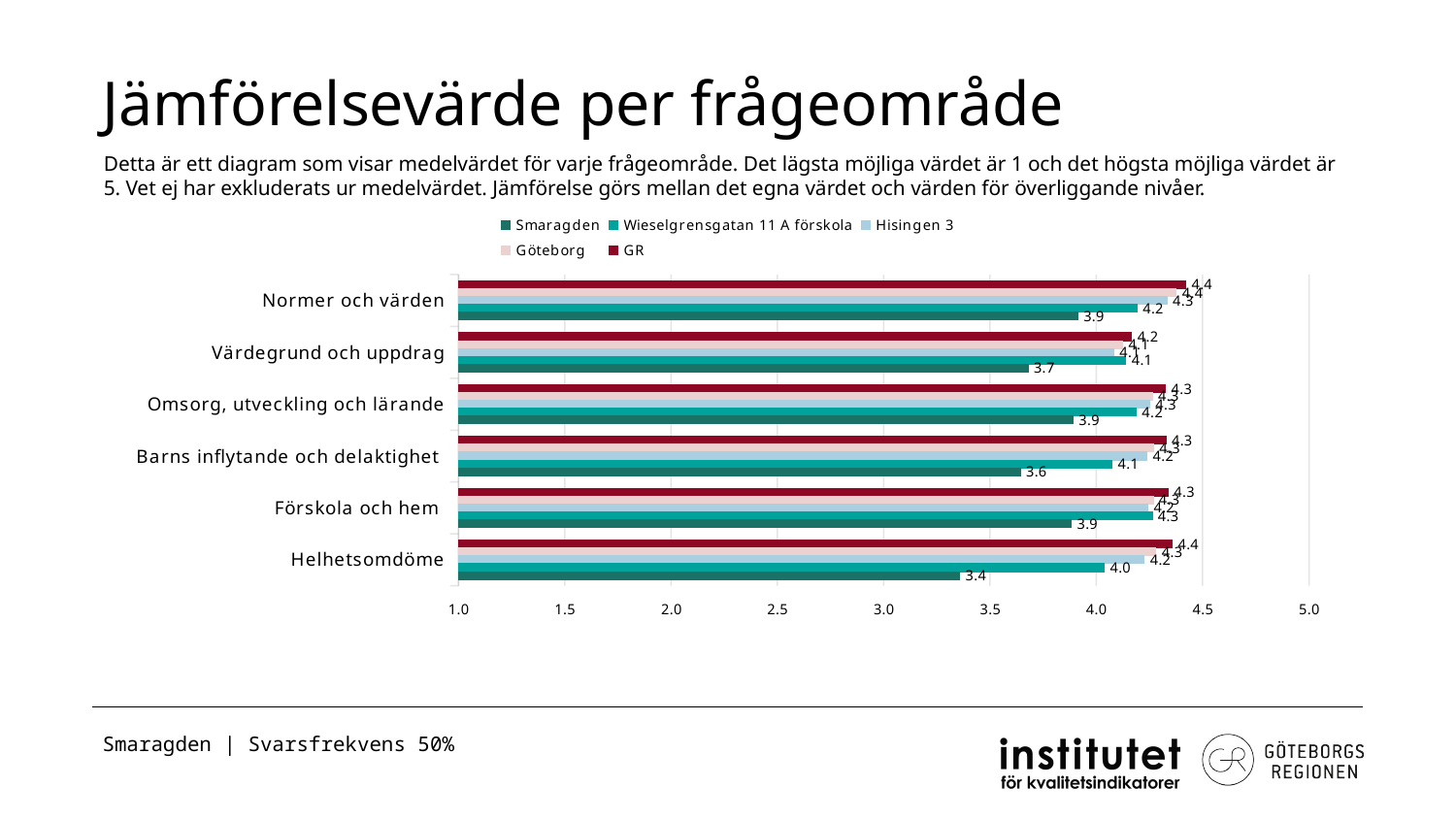
What is the difference between the Wieselgrensgatan 11 A förskola value and the Smaragden value for Barns inflytande och delaktighet? 0.5 For Helhetsomdöme, which is larger: the Smaragden value or the Wieselgrensgatan 11 A förskola value? Wieselgrensgatan 11 A förskola What is the difference between the GR value and the Smaragden value for Helhetsomdöme? 1.0 How many series does the legend list? 5 How many question areas (categories) are shown on the chart? 6 In which category does Smaragden have its lowest value? Helhetsomdöme Is the Smaragden value for Helhetsomdöme greater or less than 3.5? less What kind of chart is shown on the slide? bar chart What is the value for Smaragden in the Normer och värden category? 3.9 What is the value for GR in the Värdegrund och uppdrag category? 4.2 What is the value for Smaragden in the Helhetsomdöme category? 3.4 What is the value for Wieselgrensgatan 11 A förskola in the Helhetsomdöme category? 4.0